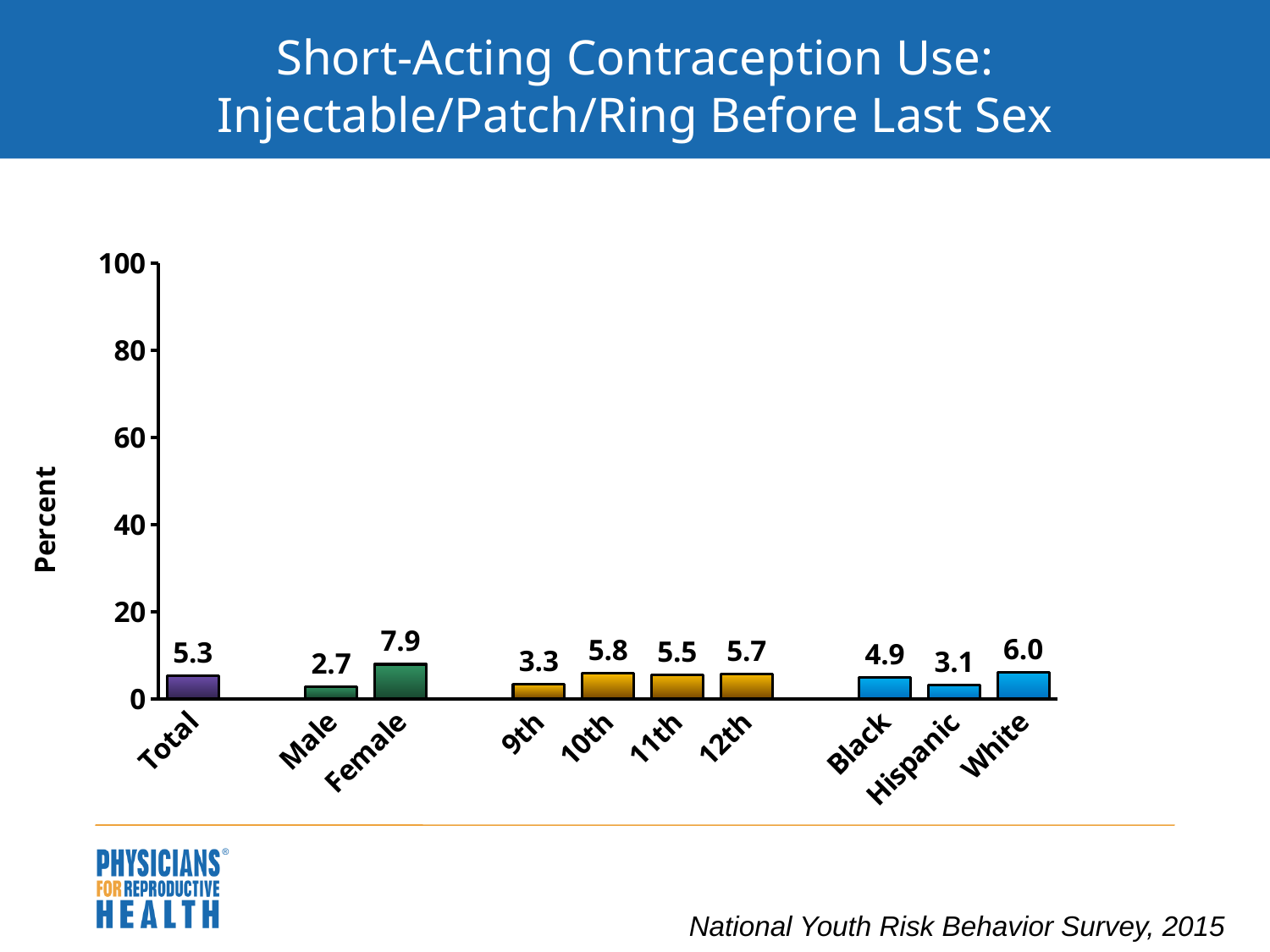
What is the value for 9th? 3.3 Which category has the highest value? Female What is the label of the y axis? Percent What is the difference between the values for White and Hispanic? 2.9 What is the value for Female? 7.9 What is the difference between the values for Female and Male? 5.2 What kind of chart is shown? Bar chart How many categories are shown on the x axis? 10 What is the value for Hispanic? 3.1 Which category has the lowest value? Male Which is larger, the value for 10th or the value for 9th? 10th What is the value for Total? 5.3